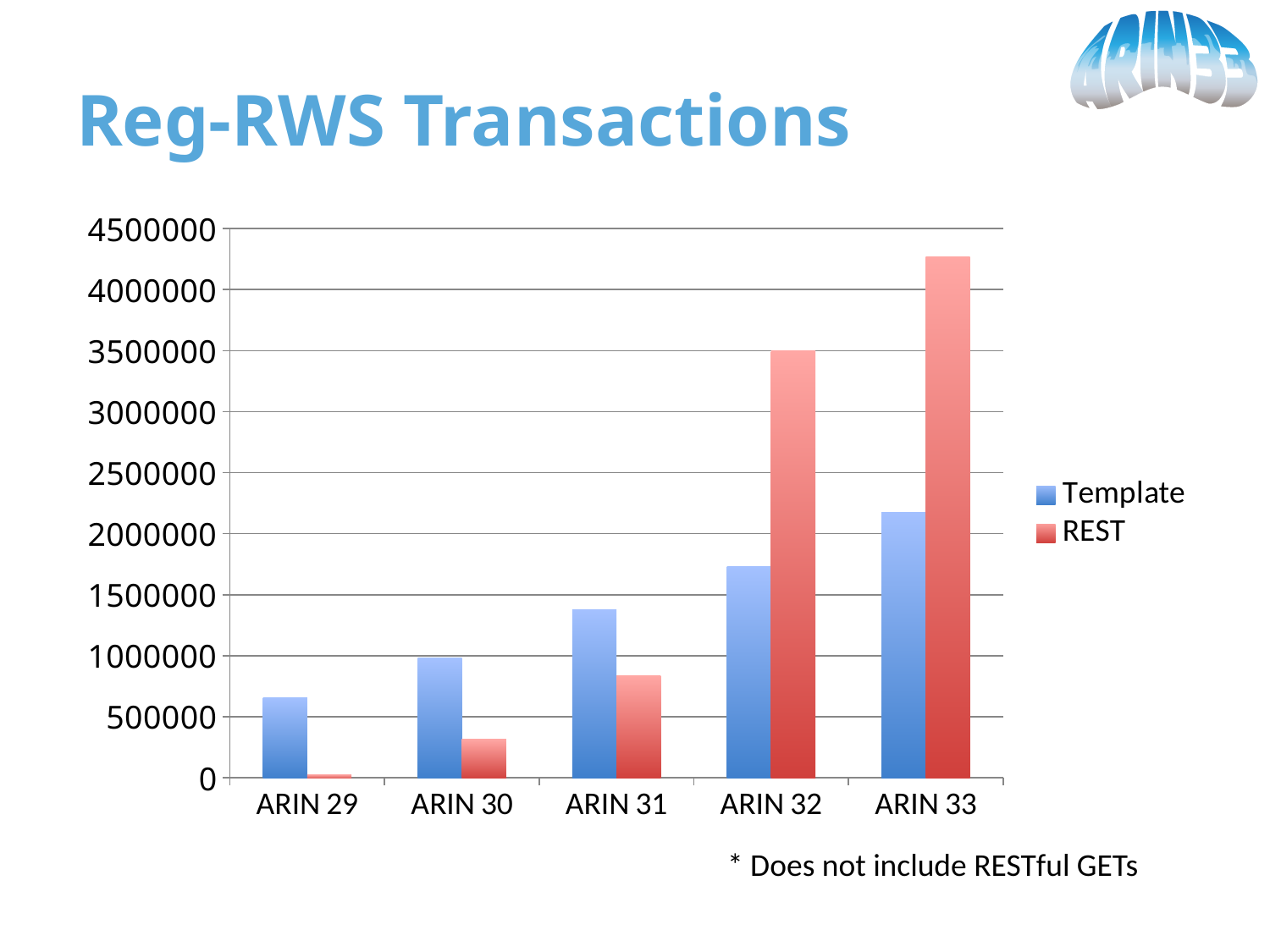
Which category has the highest REST value? ARIN 33 Is the REST value for ARIN 33 greater or less than 4000000? greater For ARIN 30, which is larger, the Template value or the REST value? Template Which category has the lowest REST value? ARIN 29 How many series does the legend list? 2 Which category has the highest Template value? ARIN 33 Is the Template value for ARIN 33 greater or less than 2000000? greater What kind of chart is shown on the slide? bar chart For ARIN 32, which is larger, the Template value or the REST value? REST Do the Template values rise or fall from ARIN 29 to ARIN 33? rise How many categories are shown on the x axis? 5 Is the REST value for ARIN 31 greater or less than 1000000? less